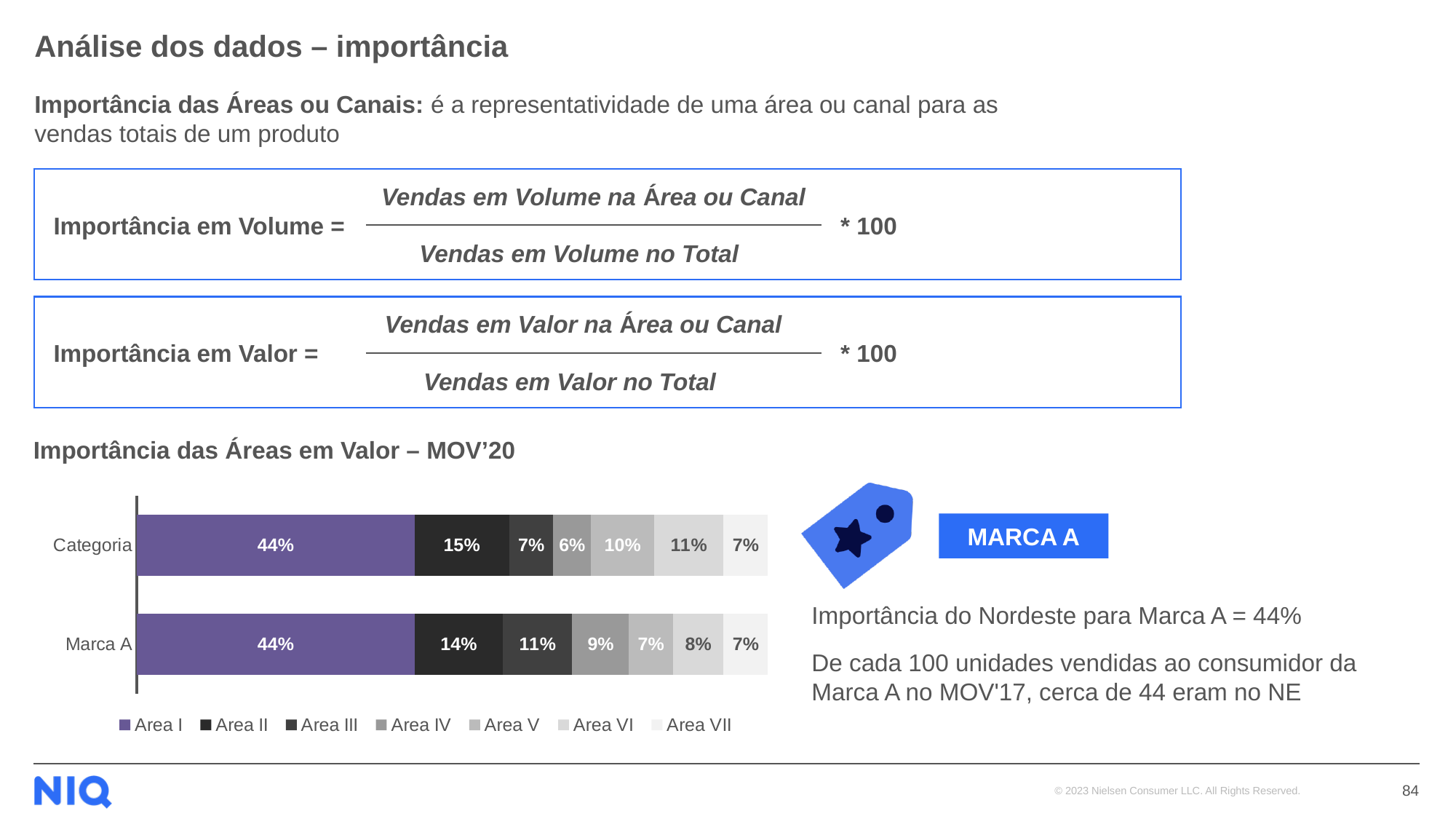
What is the value for Area V in the Categoria bar? 10% Which is larger: Area V for Categoria or Area V for Marca A? Area V for Categoria What is the value for Area III in the Marca A bar? 11% What is the title of the chart? Importância das Áreas em Valor – MOV'20 What is the difference between Area III for Marca A and Area III for Categoria? 4% Which area has the smallest share in the Categoria bar? Area IV How many series does the legend list? 7 What is the value for Area I in the Categoria bar? 44% What is the value for Area VI in the Marca A bar? 8% What kind of chart is shown on the slide? Stacked bar chart Which area has the largest share in the Marca A bar? Area I How many bars (categories) does the chart show? 2